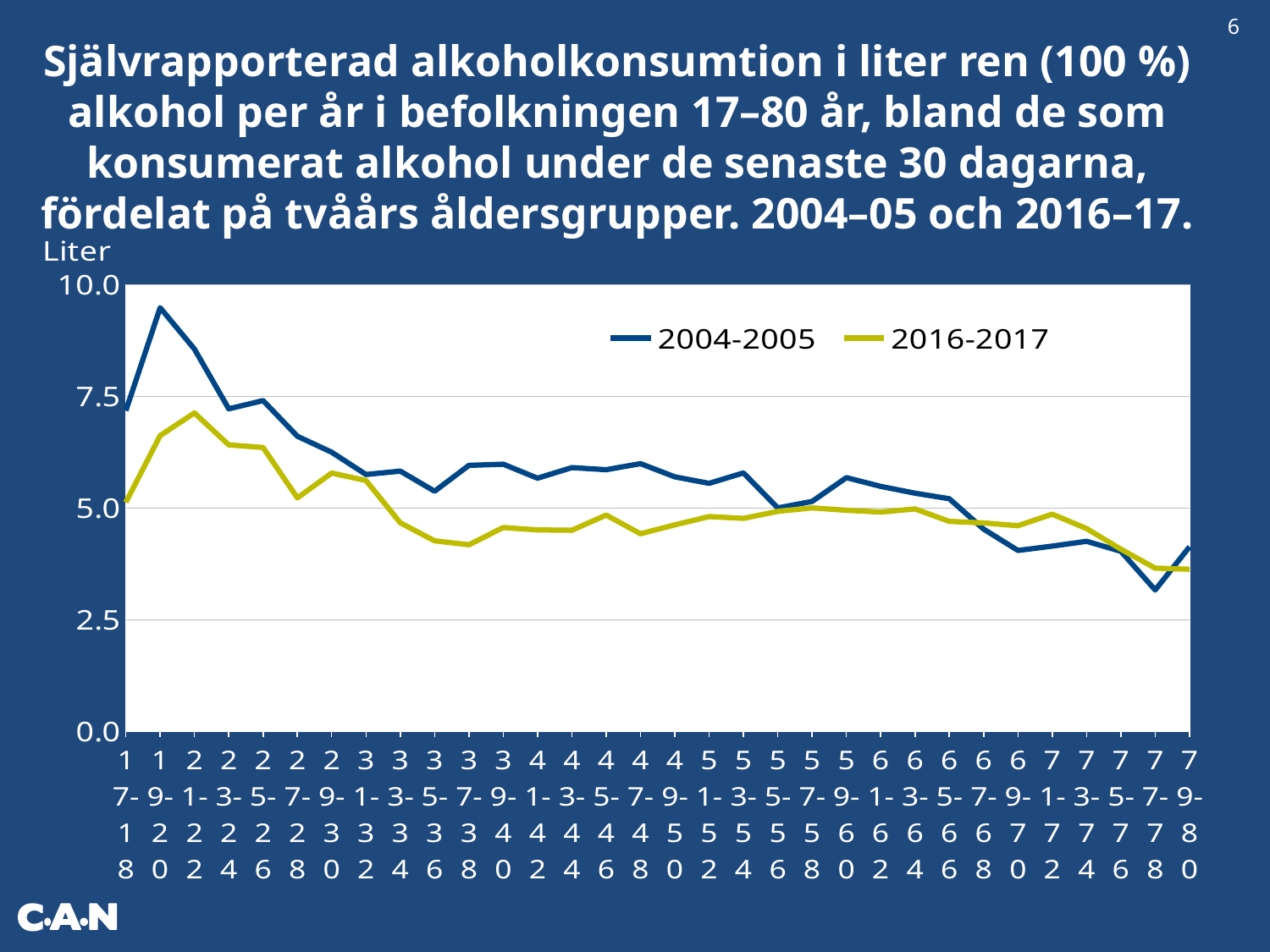
What is the label of the y axis? Liter For age group 19-20, which series has the larger value, 2004-2005 or 2016-2017? 2004-2005 Is the 2016-2017 value for age group 17-18 greater or less than 7.5? less How many series does the legend list? 2 How many age groups are plotted along the x axis? 32 For which age group is the 2004-2005 series highest? 19-20 What kind of chart is shown on the slide? line chart For which age group is the 2004-2005 series lowest? 77-78 Is the 2004-2005 value for age group 19-20 greater or less than 7.5? greater For which age group is the 2016-2017 series highest? 21-22 Is the 2004-2005 value for age group 77-78 greater or less than 5.0? less Which two series are listed in the legend? 2004-2005 and 2016-2017